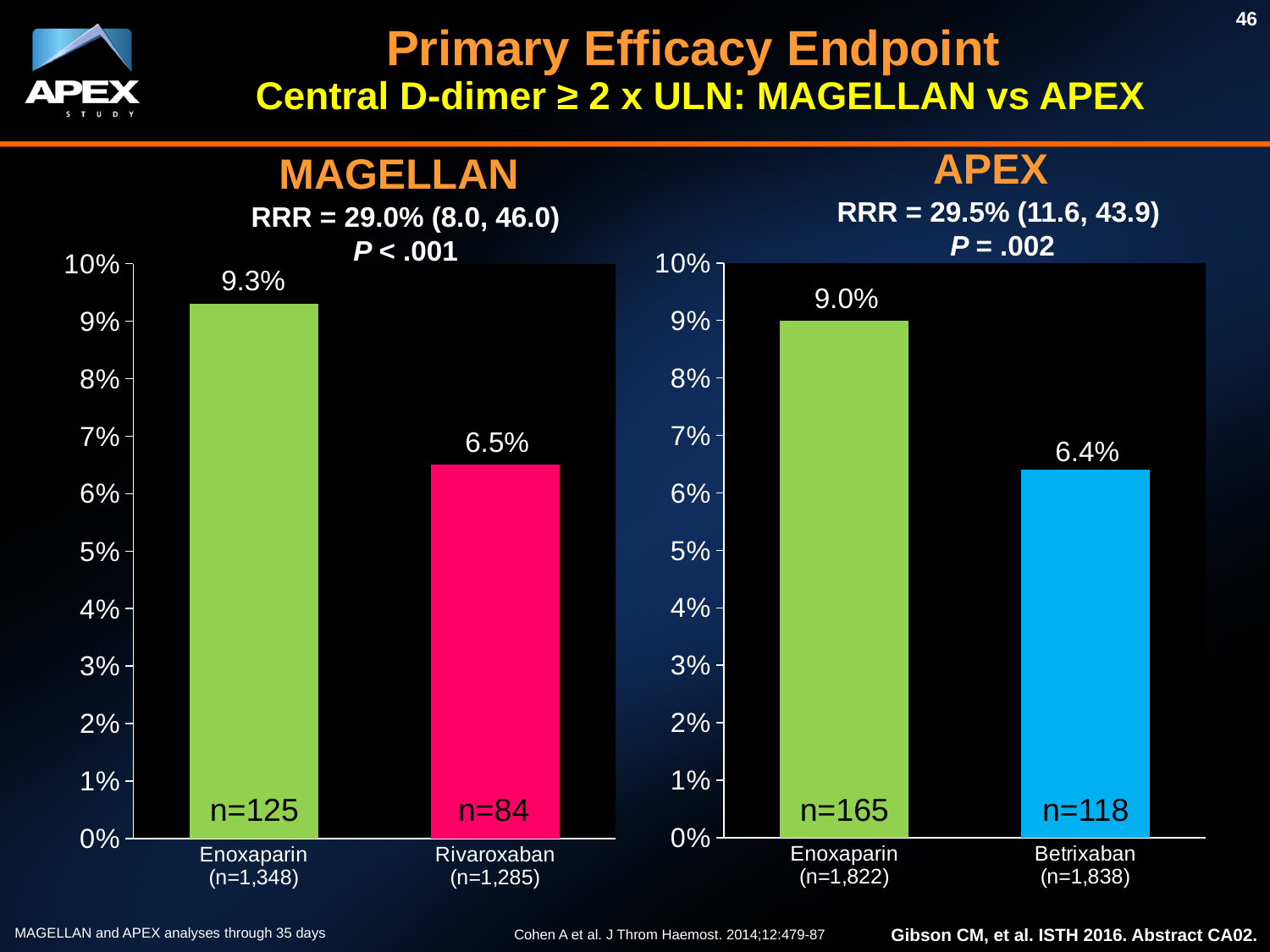
In the APEX chart, which is larger, the value for Enoxaparin or the value for Betrixaban? Enoxaparin In the APEX chart, what is the value for Enoxaparin? 9.0% In the MAGELLAN chart, what is the value for Rivaroxaban? 6.5% In the MAGELLAN chart, what is the value for Enoxaparin? 9.3% In the APEX chart, what is the value for Betrixaban? 6.4% In the APEX chart, which category has the lowest value? Betrixaban How many bars are shown in the MAGELLAN chart? 2 What type of chart is the APEX chart? Bar chart In the MAGELLAN chart, what is the number of events (n) shown inside the Rivaroxaban bar? n=84 In the MAGELLAN chart, what is the difference between the Enoxaparin and Rivaroxaban values? 2.8% In the MAGELLAN chart, which category has the highest value? Enoxaparin In the APEX chart, what is the difference between the Enoxaparin and Betrixaban values? 2.6%